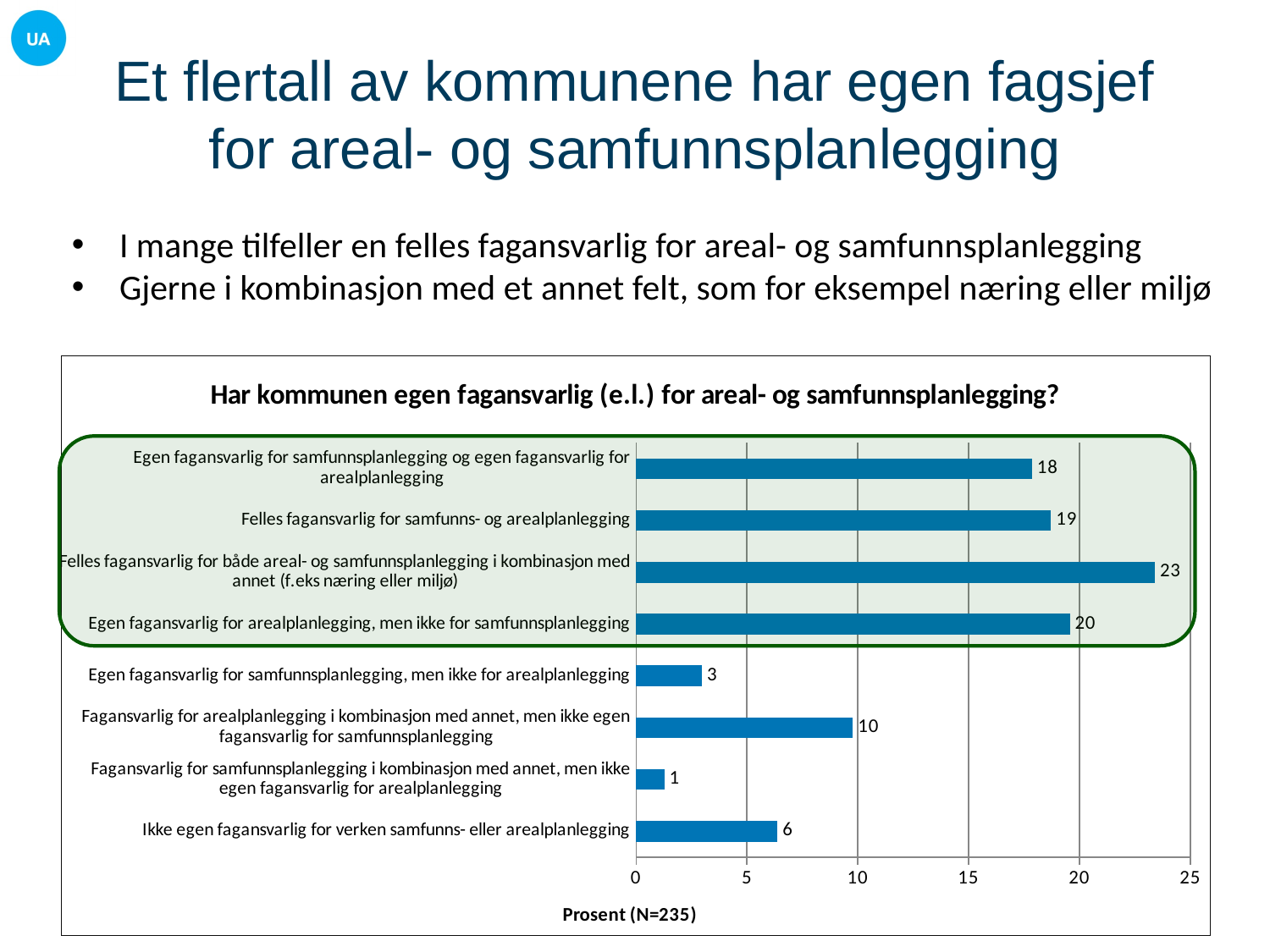
What value is shown for "Egen fagansvarlig for samfunnsplanlegging, men ikke for arealplanlegging"? 3 What is the difference between the value for "Egen fagansvarlig for arealplanlegging, men ikke for samfunnsplanlegging" and the value for "Egen fagansvarlig for samfunnsplanlegging, men ikke for arealplanlegging"? 17 What is the title of the chart? Har kommunen egen fagansvarlig (e.l.) for areal- og samfunnsplanlegging? What value is shown for "Felles fagansvarlig for samfunns- og arealplanlegging"? 19 What kind of chart is shown on the slide? bar chart What value is shown for "Ikke egen fagansvarlig for verken samfunns- eller arealplanlegging"? 6 Is the value for "Felles fagansvarlig for både areal- og samfunnsplanlegging i kombinasjon med annet (f.eks næring eller miljø)" greater or less than 20? greater How many categories are shown in the chart? 8 Which is larger: the value for "Egen fagansvarlig for samfunnsplanlegging og egen fagansvarlig for arealplanlegging" or the value for "Fagansvarlig for arealplanlegging i kombinasjon med annet, men ikke egen fagansvarlig for samfunnsplanlegging"? Egen fagansvarlig for samfunnsplanlegging og egen fagansvarlig for arealplanlegging What is the label on the horizontal axis of the chart? Prosent (N=235) Which category has the lowest value? Fagansvarlig for samfunnsplanlegging i kombinasjon med annet, men ikke egen fagansvarlig for arealplanlegging Which category has the highest value? Felles fagansvarlig for både areal- og samfunnsplanlegging i kombinasjon med annet (f.eks næring eller miljø)